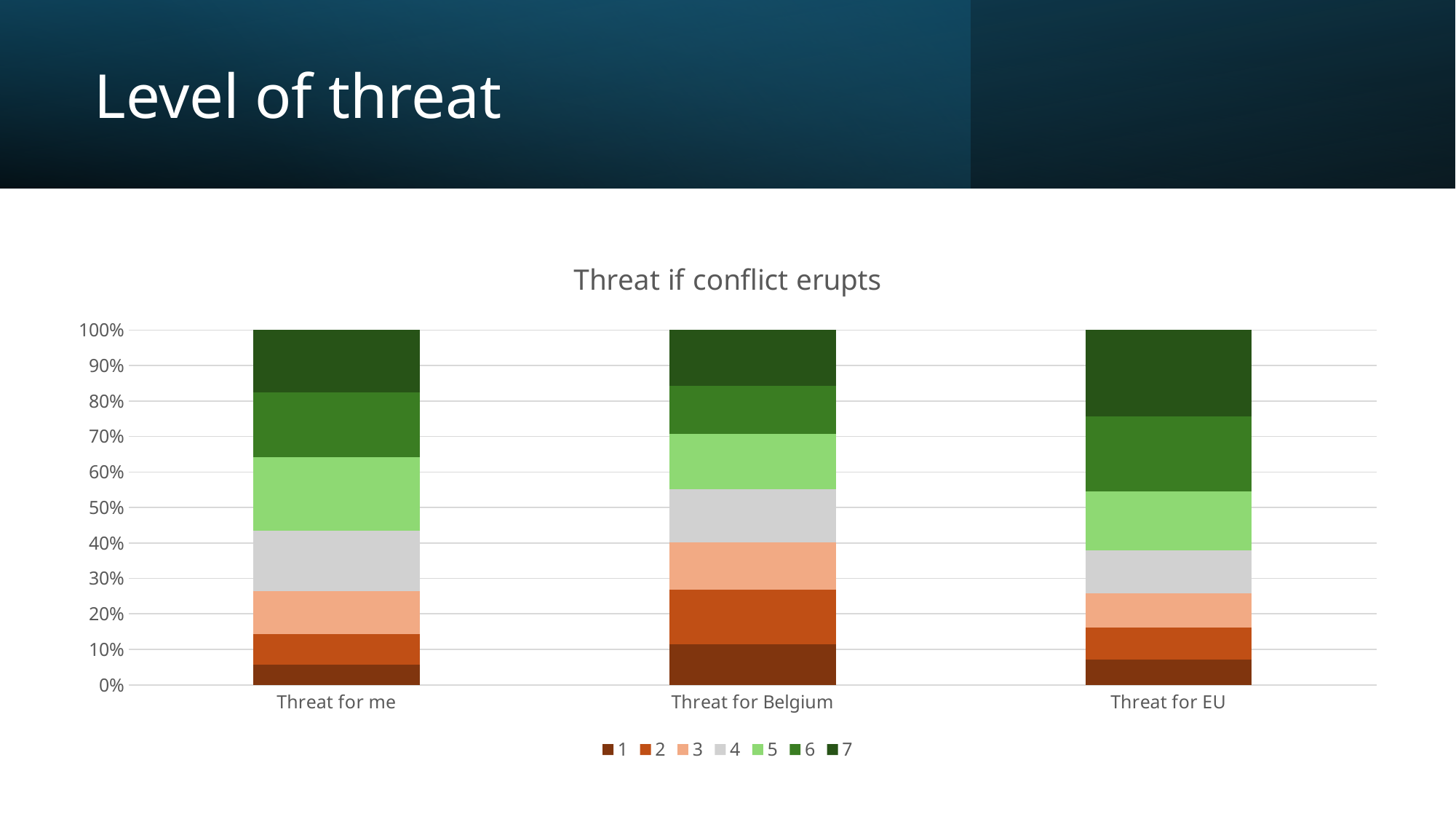
Is the share for series 7 in Threat for EU greater or less than 20%? greater How many categories are shown on the x axis of the chart? 3 Is the segment for series 7 in Threat for EU larger or smaller than the segment for series 7 in Threat for Belgium? larger Which category has the largest segment for series 5? Threat for me Is the segment for series 1 in Threat for Belgium larger or smaller than the segment for series 1 in Threat for me? larger How many series does the legend list? 7 What is the title of the chart? Threat if conflict erupts Is the share for series 1 in Threat for me greater or less than 10%? less Which category has the largest segment for series 2? Threat for Belgium Which category has the largest segment for series 7? Threat for EU What does each stacked bar total on the y axis? 100% What kind of chart is shown on the slide? Stacked bar chart